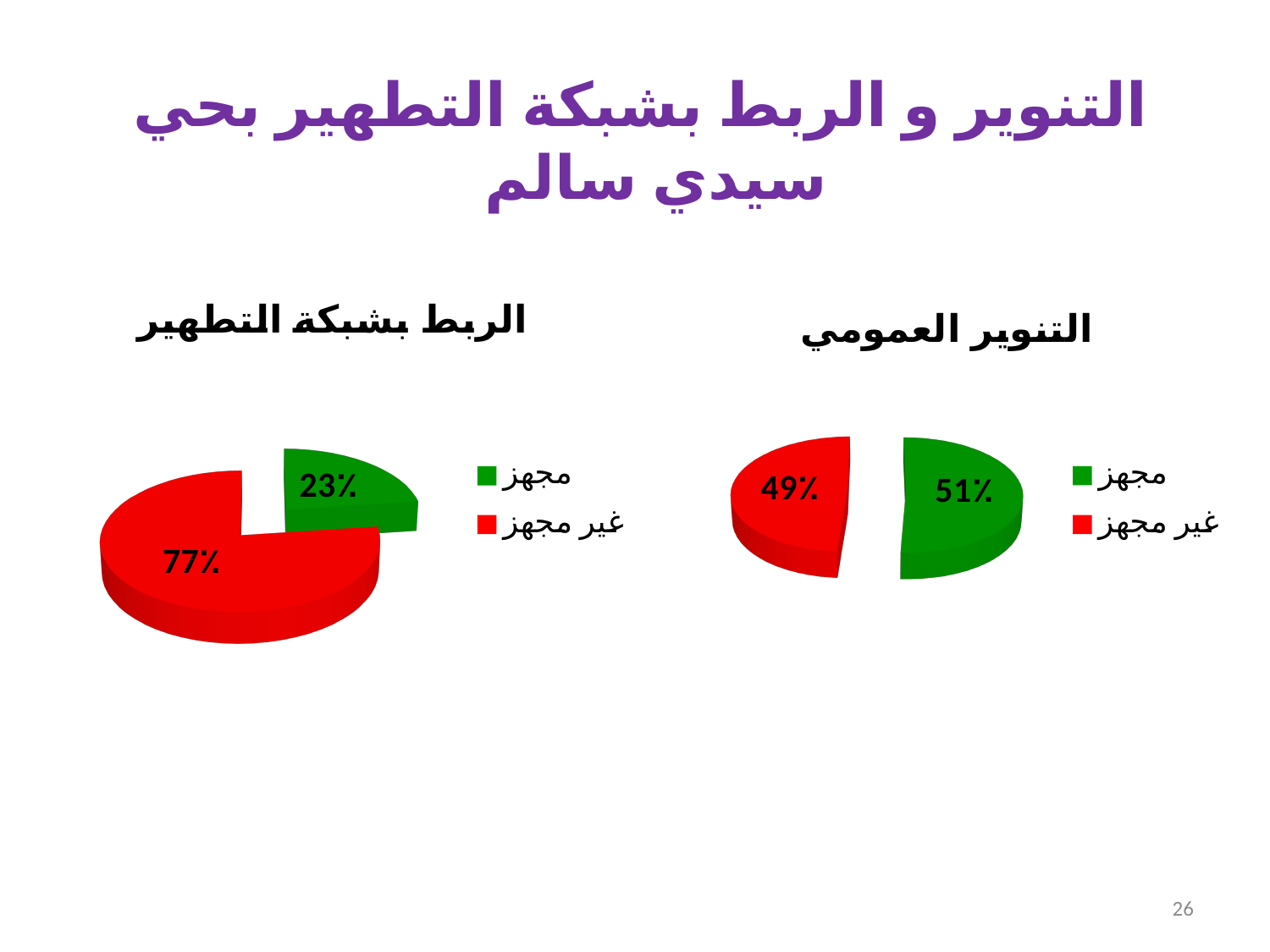
In the chart titled "الربط بشبكة التطهير", which category has the largest slice? غير مجهز In the chart titled "الربط بشبكة التطهير", which is larger, "مجهز" or "غير مجهز"? غير مجهز What type of chart is the chart titled "التنوير العمومي"? Pie chart In the chart titled "التنوير العمومي", what is the value for "مجهز"? 51% How many slices does the chart titled "الربط بشبكة التطهير" have? 2 In the chart titled "الربط بشبكة التطهير", which category has the smallest slice? مجهز In the chart titled "الربط بشبكة التطهير", what is the value for "غير مجهز"? 77% In the chart titled "الربط بشبكة التطهير", what is the value for "مجهز"? 23% In the chart titled "التنوير العمومي", what is the difference between "مجهز" and "غير مجهز"? 2% In the chart titled "التنوير العمومي", what is the value for "غير مجهز"? 49% In the chart titled "التنوير العمومي", what colour is the "غير مجهز" slice? Red In the chart titled "الربط بشبكة التطهير", what is the difference between "غير مجهز" and "مجهز"? 54%